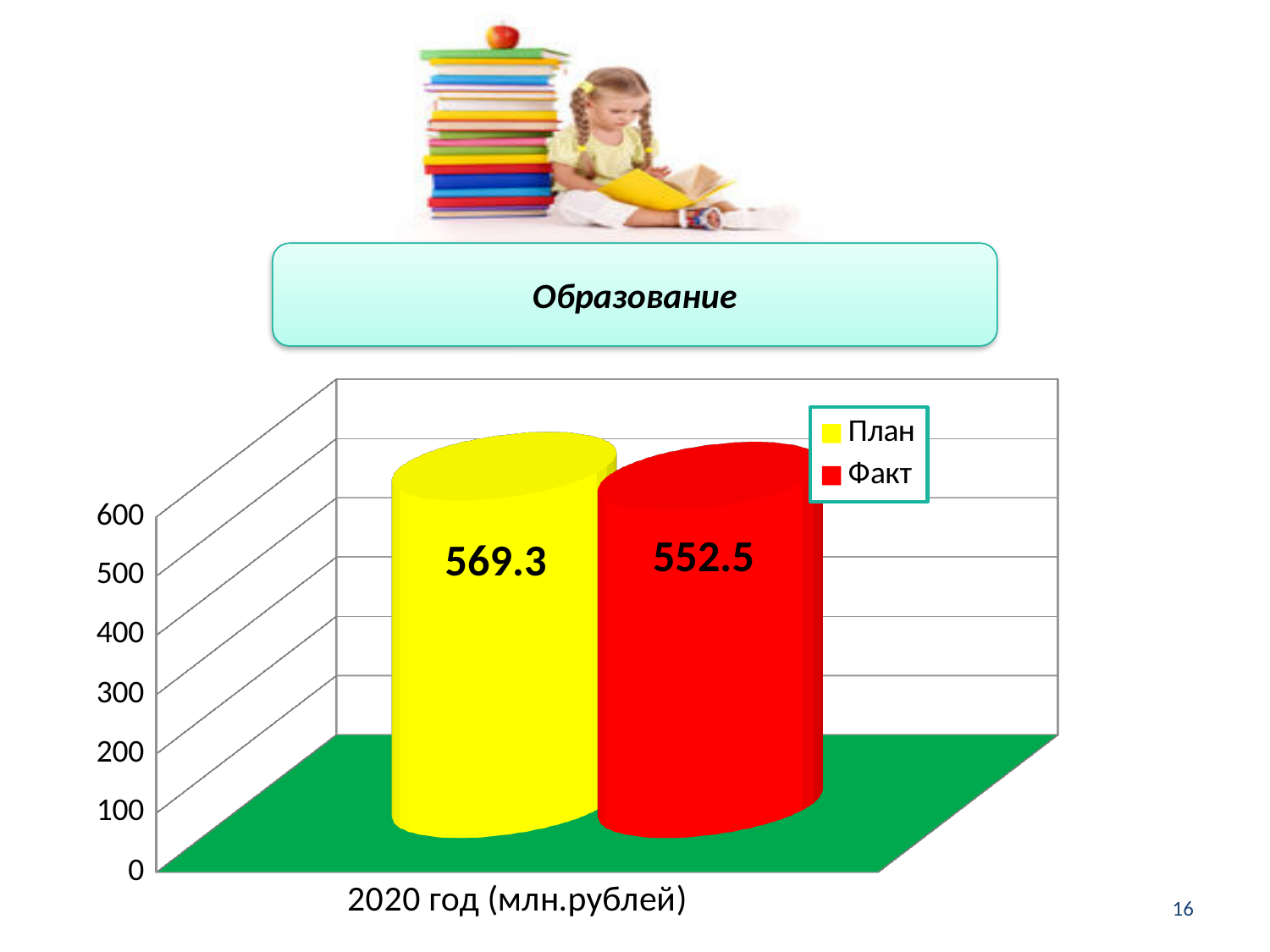
How many categories are shown on the x axis? 1 What is the label of the category on the x axis? 2020 год (млн.рублей) Which series has the higher value, План or Факт? План Is the value for Факт greater or less than 500? greater How many series does the legend list? 2 What is the value of Факт (actual) for 2020 год? 552.5 Which series has the lowest value on the chart? Факт What colour represents the Факт series? red What kind of chart is shown on the slide? bar chart What is the difference between the План and Факт values? 16.8 What is the value of План (plan) for 2020 год? 569.3 Is the value for План greater or less than 600? less